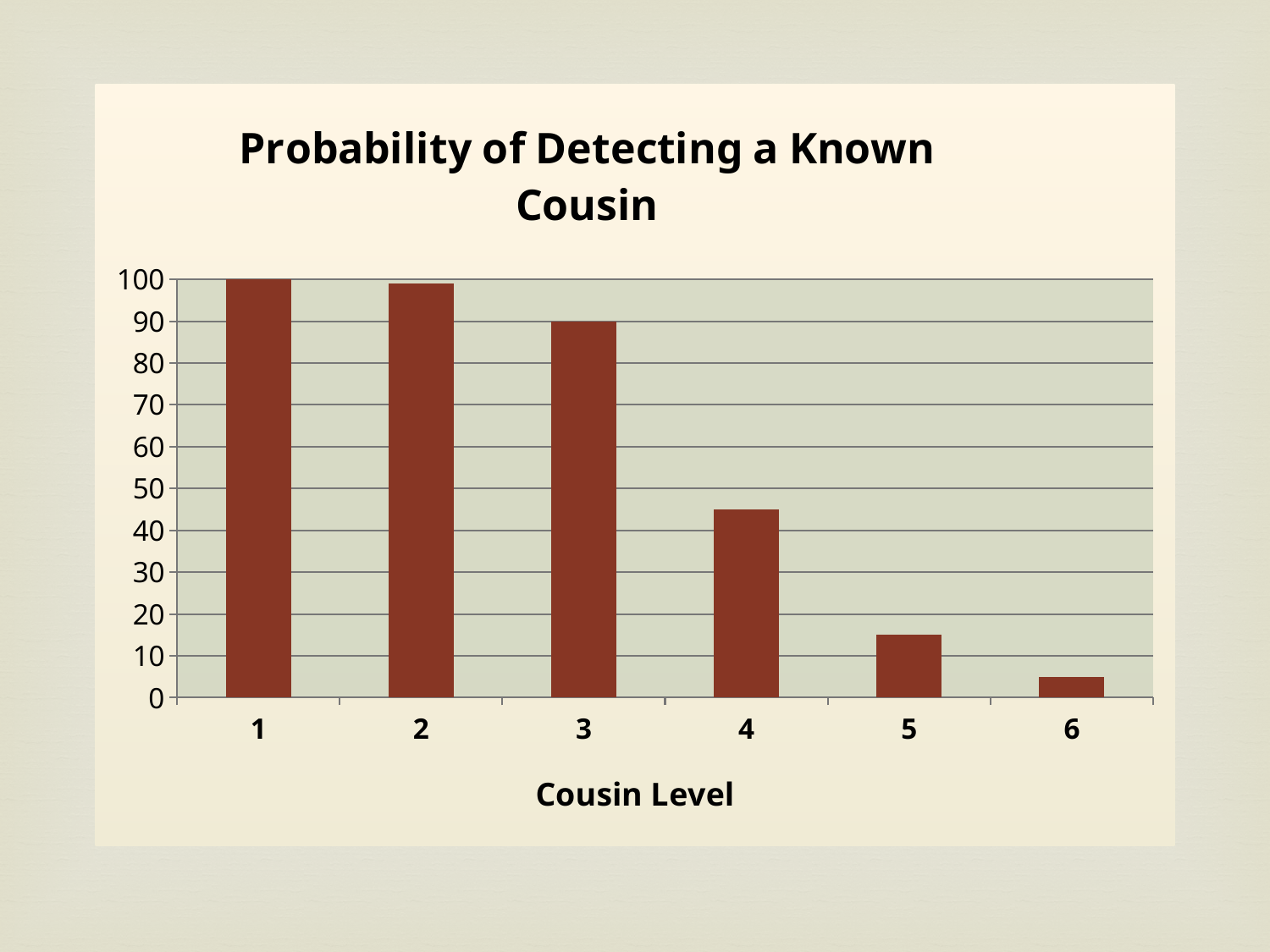
What kind of chart is shown on the slide? bar chart What is the title of the chart? Probability of Detecting a Known Cousin Which cousin level has the highest value? 1 Is the value for cousin level 4 greater or less than 50? less How many cousin levels are plotted on the chart? 6 Do the values rise or fall as the cousin level increases from 1 to 6? fall What is the label of the x axis? Cousin Level Which cousin level has the lowest value? 6 What is the value for cousin level 3? 90 Is the value for cousin level 5 greater or less than 10? greater Which has a larger value, cousin level 3 or cousin level 4? cousin level 3 What is the value for cousin level 1? 100